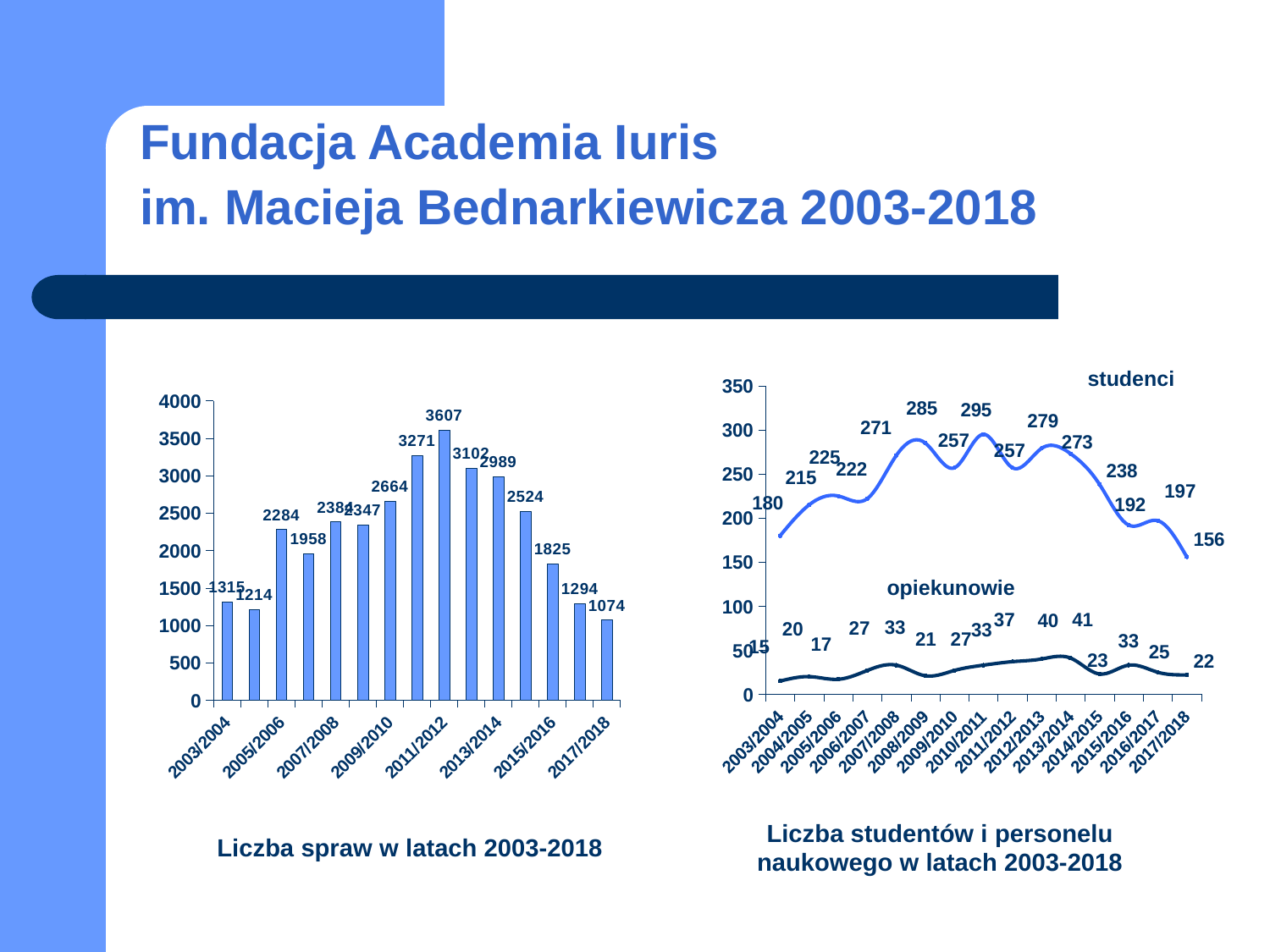
In the right chart 'Liczba studentów i personelu naukowego w latach 2003-2018', in which year is the opiekunowie value highest? 2013/2014 In the right chart 'Liczba studentów i personelu naukowego w latach 2003-2018', what is the studenci value for 2010/2011? 295 In the left chart 'Liczba spraw w latach 2003-2018', which is larger, the value for 2009/2010 or the value for 2013/2014? 2013/2014 How many bars are plotted in the left chart 'Liczba spraw w latach 2003-2018'? 15 In the left chart 'Liczba spraw w latach 2003-2018', what is the difference between the values for 2011/2012 and 2017/2018? 2533 In the left chart 'Liczba spraw w latach 2003-2018', which year has the lowest value? 2017/2018 What kind of chart is the left chart, 'Liczba spraw w latach 2003-2018'? bar chart How many series are plotted in the right chart 'Liczba studentów i personelu naukowego w latach 2003-2018'? 2 In the right chart 'Liczba studentów i personelu naukowego w latach 2003-2018', in which year is the studenci value lowest? 2017/2018 In the left chart 'Liczba spraw w latach 2003-2018', which year has the highest value? 2011/2012 In the left chart 'Liczba spraw w latach 2003-2018', what is the value for 2011/2012? 3607 In the right chart 'Liczba studentów i personelu naukowego w latach 2003-2018', what is the difference between the studenci values for 2003/2004 and 2017/2018? 24